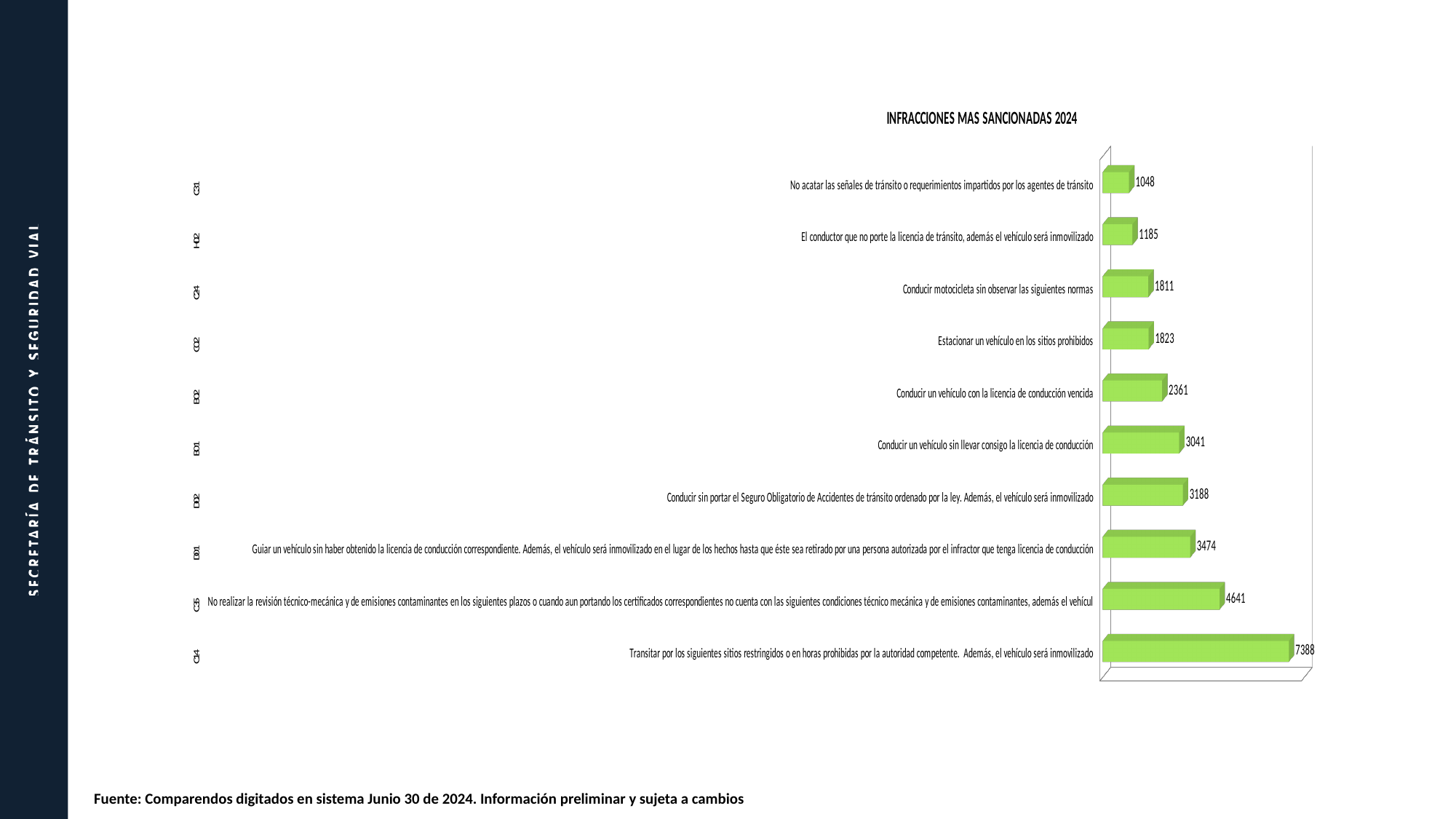
What is the value for "Conducir motocicleta sin observar las siguientes normas"? 1811 What is the value for "Conducir un vehículo con la licencia de conducción vencida"? 2361 How many categories are plotted in the chart? 10 What colour are the bars in the chart? Green What is the title of the chart? INFRACCIONES MAS SANCIONADAS 2024 What kind of chart is shown on the slide? Bar chart Which category has the highest value? Transitar por los siguientes sitios restringidos o en horas prohibidas por la autoridad competente. Además, el vehículo será inmovilizado Which category has the lowest value? No acatar las señales de tránsito o requerimientos impartidos por los agentes de tránsito What is the difference between the value for "Transitar por los siguientes sitios restringidos..." (7388) and the value for "No realizar la revisión técnico-mecánica..." (4641)? 2747 What is the value for "Estacionar un vehículo en los sitios prohibidos"? 1823 What is the difference between the value for "Conducir un vehículo sin llevar consigo la licencia de conducción" and the value for "Conducir un vehículo con la licencia de conducción vencida"? 680 Which is larger: the value for "Conducir sin portar el Seguro Obligatorio de Accidentes de tránsito..." or the value for "Guiar un vehículo sin haber obtenido la licencia de conducción correspondiente..."? Guiar un vehículo sin haber obtenido la licencia de conducción correspondiente...